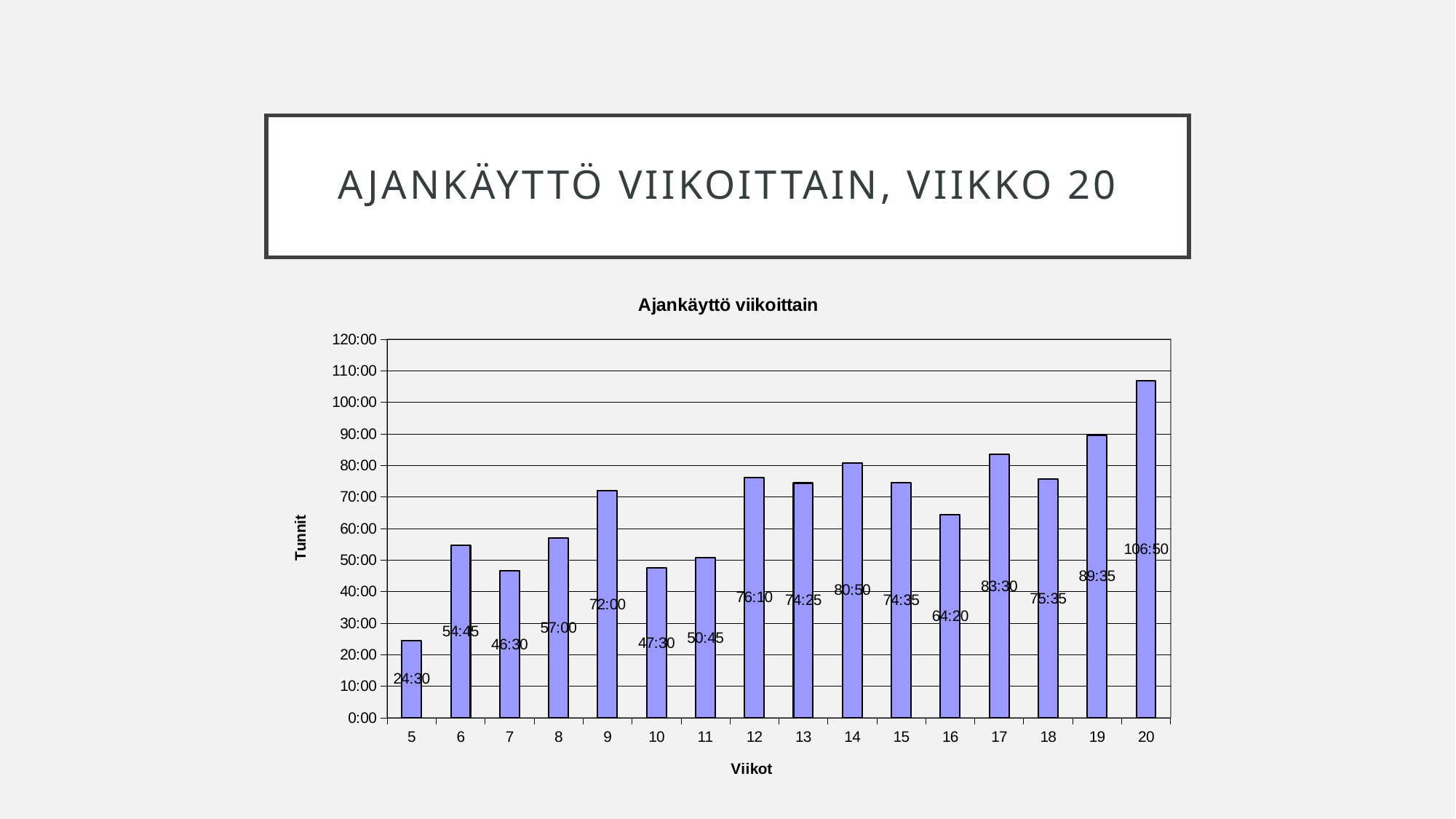
What kind of chart is this? bar chart What is the difference between the values for week 20 and week 5? 82:20 Which week has the highest value? 20 What is the label of the y axis? Tunnit Which week has the lowest value? 5 What is the value for week 14? 80:50 Is the value for week 19 greater or less than 80:00? greater What is the value for week 5? 24:30 How many weeks are shown on the x axis? 16 What is the difference between the values for week 9 and week 8? 15:00 Which is larger, the value for week 12 or week 14? week 14 What is the value for week 17? 83:30